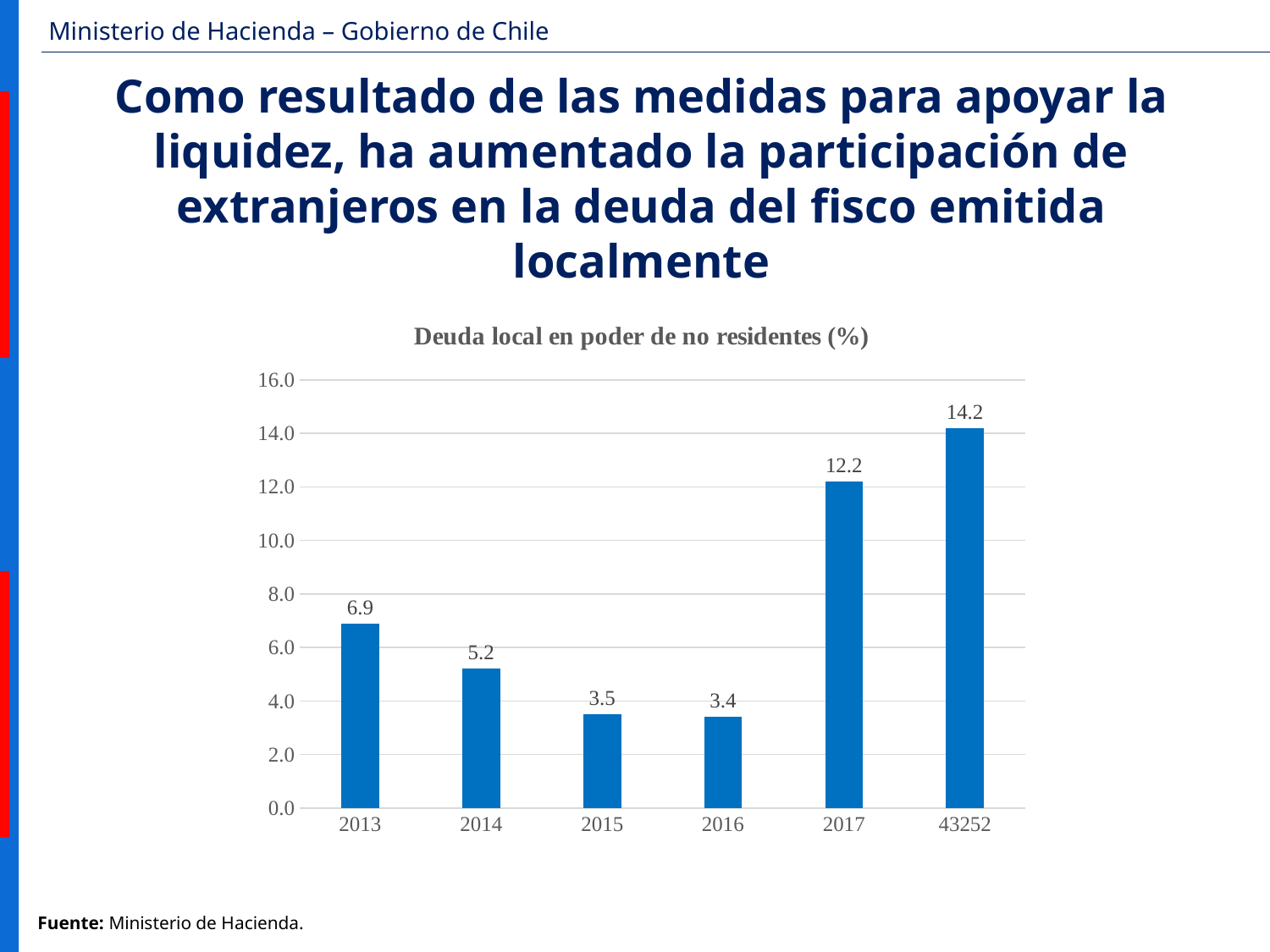
Is the value for 2017 greater or less than 10.0? greater What kind of chart is shown on the slide? bar chart What is the difference between the values for 2013 and 2014? 1.7 How many bars are shown in the chart? 6 What is the title of the chart? Deuda local en poder de no residentes (%) Which is larger, the value for 2014 or the value for 2015? 2014 Which year has the lowest value? 2016 What is the value for 2013 in the chart? 6.9 What is the difference between the values for 2017 and 2016? 8.8 Which category has the highest value? 43252 What is the value for the category labelled 43252? 14.2 What is the value for 2017 in the chart? 12.2